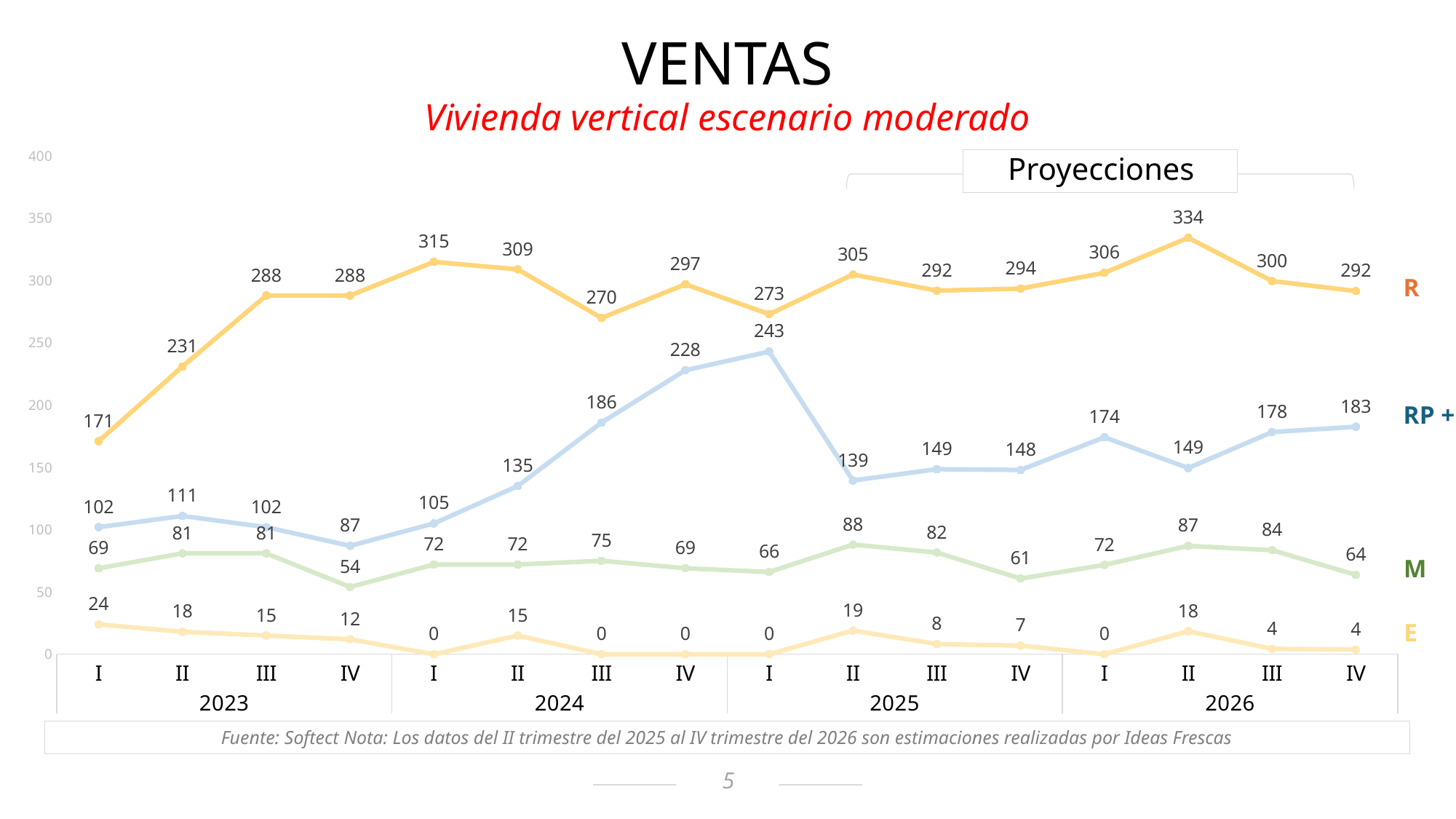
What is the value of the E series in quarter I of 2023? 24 How many quarters are plotted along the x axis? 16 Which is larger: the RP + value in quarter IV of 2024 or the R value in quarter III of 2024? R in III 2024 What is the red subtitle shown under the chart title VENTAS? Vivienda vertical escenario moderado What is the value of the RP + series in quarter I of 2025? 243 What is the difference between the R value and the RP + value in quarter IV of 2026? 109 Does the R series rise or fall from quarter I of 2023 to quarter I of 2024? Rise In which quarter is the M series at its lowest value? IV 2023 In which quarter does the R series reach its highest value? II 2026 What kind of chart is shown on the slide? Line chart What is the value of the R series in quarter II of 2026? 334 How many series are shown in the chart? 4